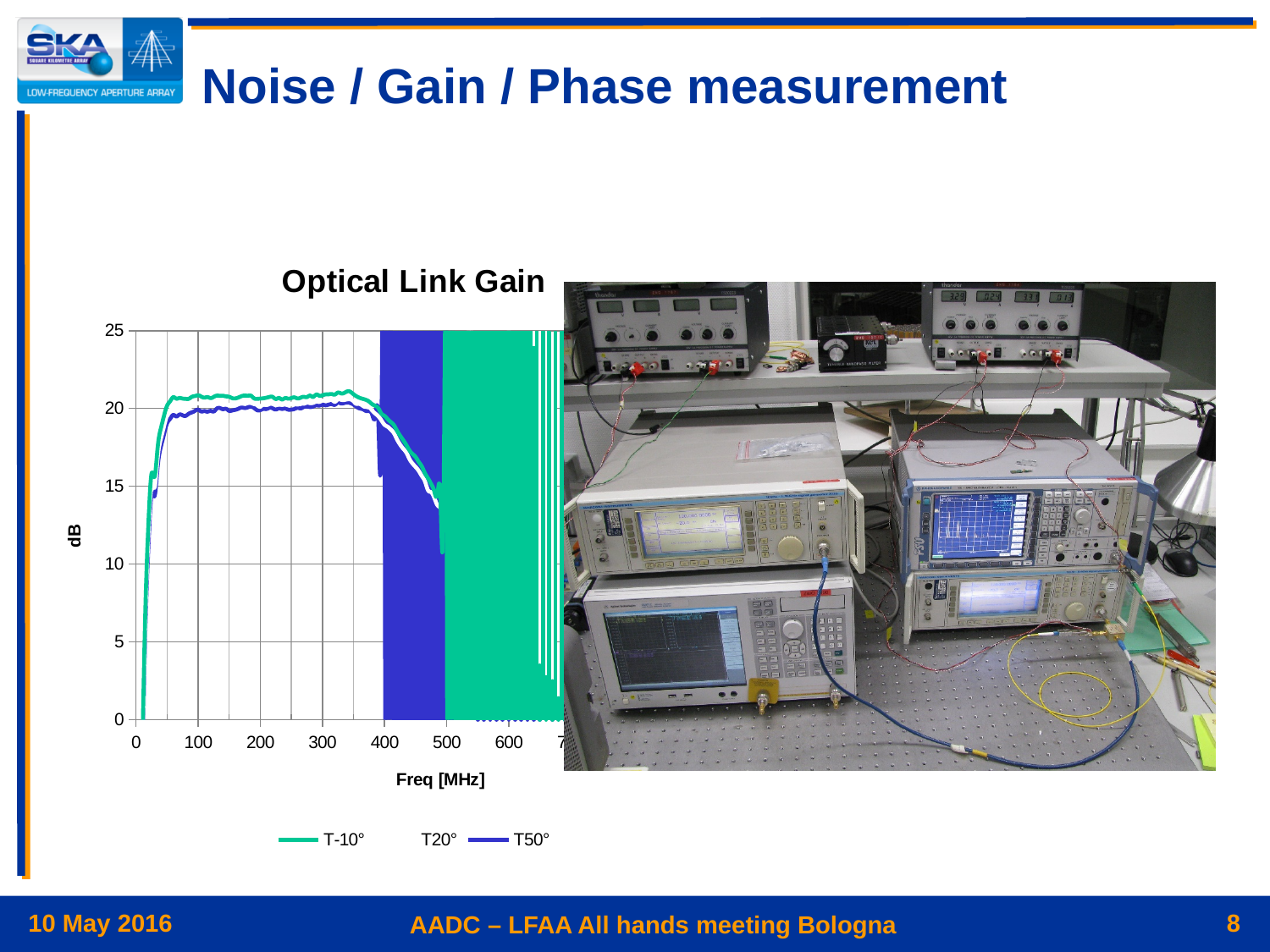
In the Optical Link Gain chart, do the values rise or fall between 0 MHz and 50 MHz? rise What kind of chart is the Optical Link Gain chart? line chart What is the label of the x axis of the Optical Link Gain chart? Freq [MHz] In the Optical Link Gain chart, is the value for T50° at 450 MHz greater or less than 20? less In the Optical Link Gain chart, which series has the higher value at 200 MHz, T-10° or T50°? T-10° How many series does the legend of the Optical Link Gain chart list? 3 In the Optical Link Gain chart, is the value for T-10° at 200 MHz greater or less than 20? greater In the Optical Link Gain chart, is the value for T-10° at 100 MHz greater or less than 15? greater In the Optical Link Gain chart, do the values rise or fall between 400 MHz and 500 MHz? fall What is the highest tick value shown on the y axis of the Optical Link Gain chart? 25 What is the title of the chart on the slide? Optical Link Gain